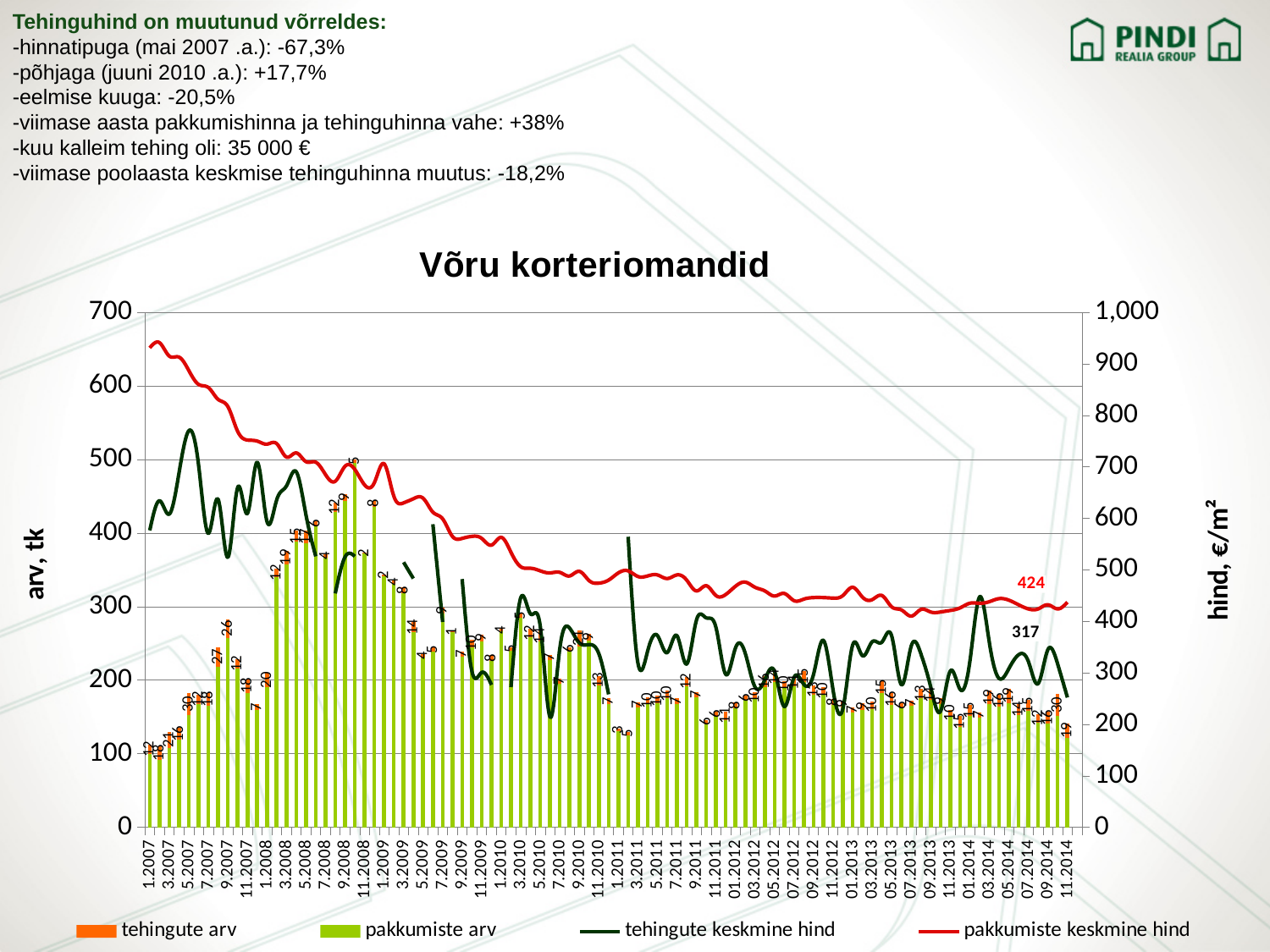
What is the difference between the labelled end values 424 (pakkumiste keskmine hind) and 317 (tehingute keskmine hind)? 107 How many series does the chart legend list? 4 Does the pakkumiste keskmine hind line rise or fall overall from 2007 to 2014? fall What colour is the pakkumiste keskmine hind line in the legend? red What is the title of the chart? Võru korteriomandid What kind of chart is shown on the slide? bar and line chart What is the labelled value of the tehingute keskmine hind line at the end of the chart? 317 At the end of the chart, which is larger: pakkumiste keskmine hind or tehingute keskmine hind? pakkumiste keskmine hind Is the pakkumiste keskmine hind value at the start of the chart (1.2007) greater or less than 800? greater In which year does the pakkumiste keskmine hind line reach its highest value? 2007 Is the pakkumiste arv bar for 11.2008 greater or less than 400? less What is the labelled value of the pakkumiste keskmine hind line at the end of the chart? 424